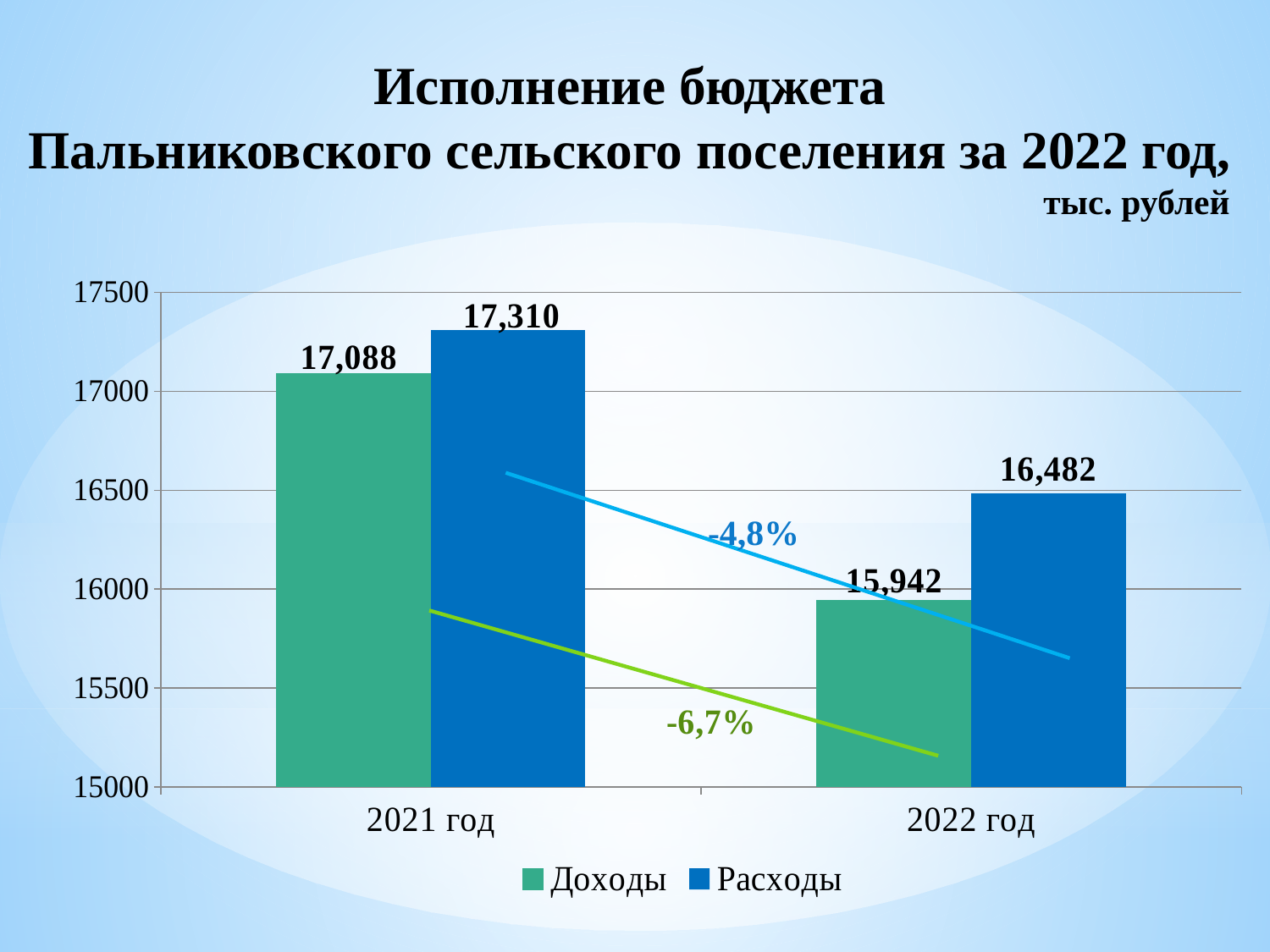
What is the value of Доходы for 2021 год? 17,088 What is the value of Доходы for 2022 год? 15,942 Which is larger in 2022 год, Доходы or Расходы? Расходы What is the value of Расходы for 2022 год? 16,482 Which bar has the highest value on the chart? Расходы, 2021 год What kind of chart is shown on the slide? Bar chart What percentage change is labelled on the green trend line? -6,7% How many series does the legend list? 2 What is the difference between Расходы and Доходы in 2022 год? 540 Which bar has the lowest value on the chart? Доходы, 2022 год Do the Доходы values rise or fall from 2021 год to 2022 год? Fall What is the difference between Расходы and Доходы in 2021 год? 222